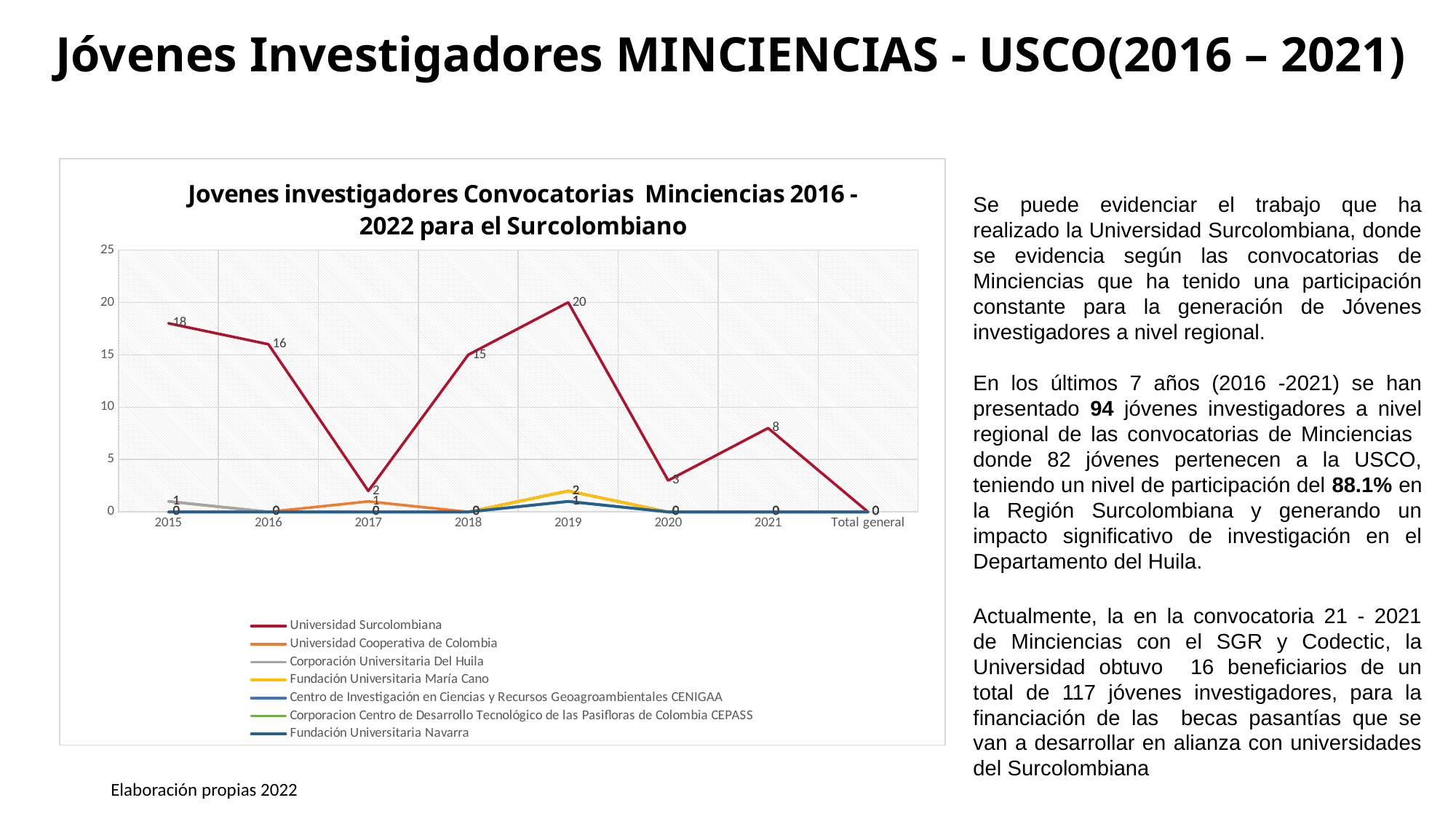
Which is larger for Universidad Surcolombiana: the value in 2016 or the value in 2018? 2016 What kind of chart is shown on the slide? line chart What is the value for Universidad Surcolombiana in 2017? 2 Among the years 2015 to 2021, in which year is the value for Universidad Surcolombiana lowest? 2017 How many series does the legend list? 7 What is the difference between the Universidad Surcolombiana values for 2019 and 2020? 17 What is the value for Universidad Surcolombiana in 2015? 18 How many categories are shown on the x axis? 8 Is the value for Universidad Surcolombiana in 2018 greater or less than 10? greater In which year does Universidad Surcolombiana reach its highest value? 2019 What is the value for Universidad Surcolombiana in 2021? 8 What is the value for Universidad Surcolombiana in 2019? 20